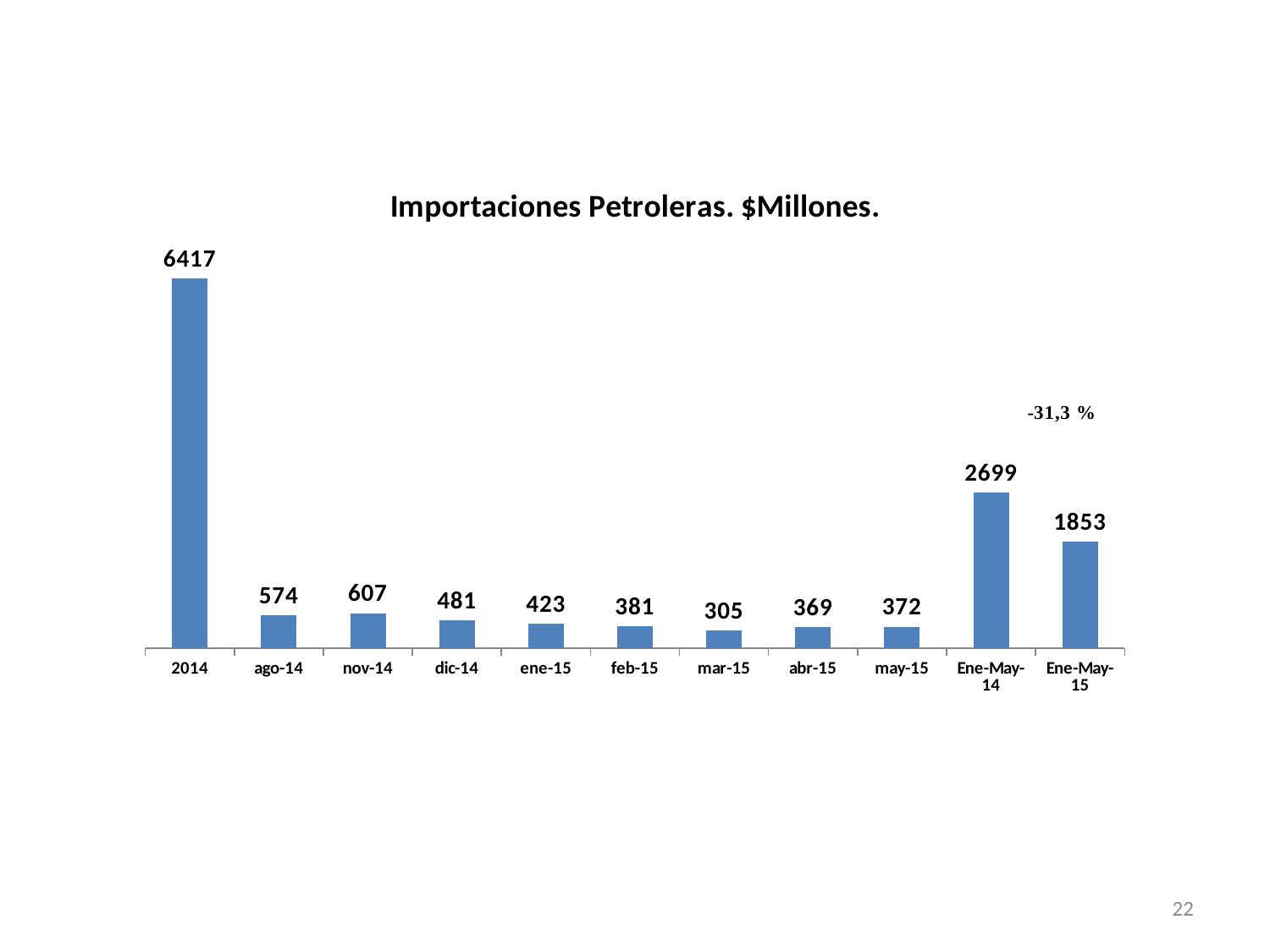
What is the value for 2014? 6417 What is the value for mar-15? 305 Which is larger, ago-14 or nov-14? nov-14 Which category has the highest value? 2014 What is the title of the chart? Importaciones Petroleras. $Millones. What is the value for Ene-May-15? 1853 What percentage change is annotated above the Ene-May-15 bar? -31,3 % What is the difference between Ene-May-14 and Ene-May-15? 846 How many bars are shown in the chart? 11 Which category has the lowest value? mar-15 Do the values rise or fall from dic-14 to mar-15? fall What kind of chart is this? bar chart